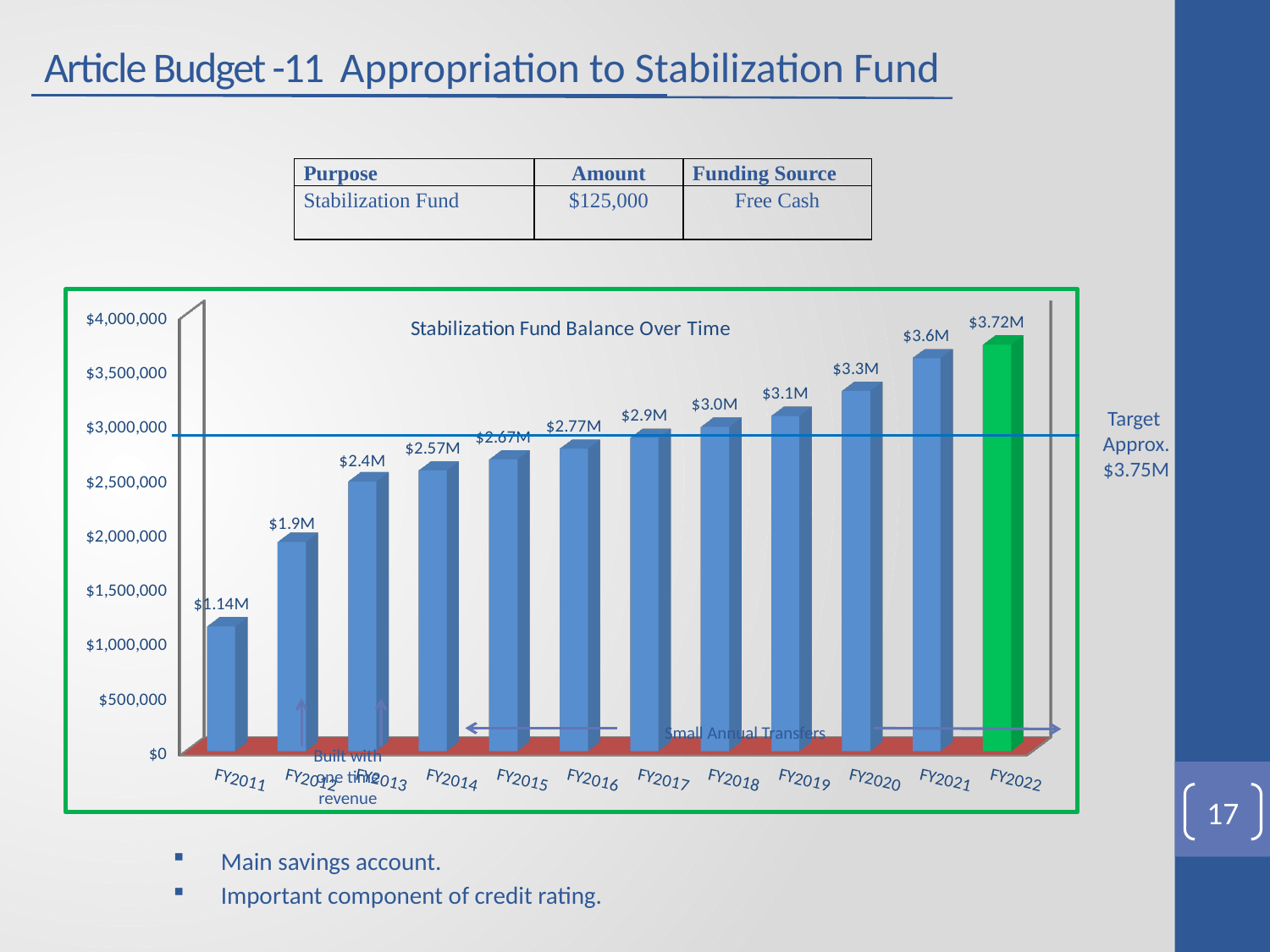
What kind of chart is shown on the slide? Bar chart How many fiscal years are shown on the x axis of the chart? 12 What is the stabilization fund balance for FY2011? $1.14M Which is larger, the balance for FY2013 or the balance for FY2012? FY2013 Which fiscal year has the highest stabilization fund balance? FY2022 What is the stabilization fund balance for FY2022? $3.72M What is the difference between the FY2022 and FY2021 stabilization fund balances? $0.12M Is the value for FY2020 greater or less than $3,000,000? greater What is the stabilization fund balance for FY2017? $2.9M What is the title of the chart on the slide? Stabilization Fund Balance Over Time Do the stabilization fund balances rise or fall from FY2011 to FY2022? Rise Which fiscal year has the lowest stabilization fund balance? FY2011